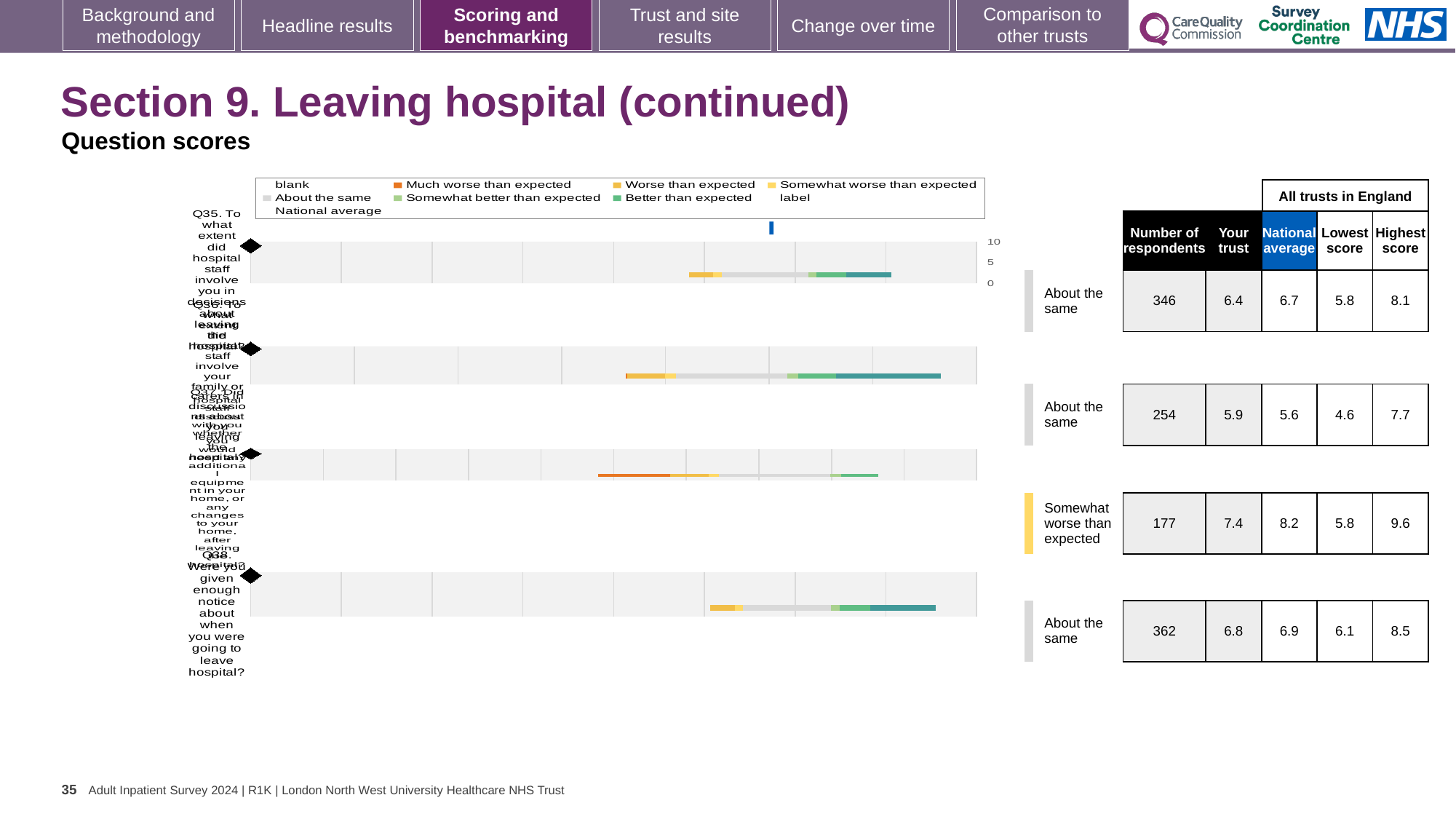
How many question rows (bars) are plotted in the chart? 4 Which question row has the highest 'Your trust' score? the third row (7.4) Which benchmark category is given for the third question row? Somewhat worse than expected Which legend entry is shown in dark green in the chart legend? Better than expected How many respondents are listed for the last question row (Q38)? 362 What is the highest score across all trusts in England for the last question row (Q38)? 8.5 Which question row has the lowest 'Your trust' score? the second row (5.9) What is the national average for the first question row (Q35)? 6.7 What kind of chart is used to show the question scores on this slide? bar chart For the first question row (Q35), is the 'Your trust' score or the national average larger? national average What is the 'Your trust' score for the first question row (Q35)? 6.4 Which legend entry is shown in dark orange in the chart legend? Much worse than expected